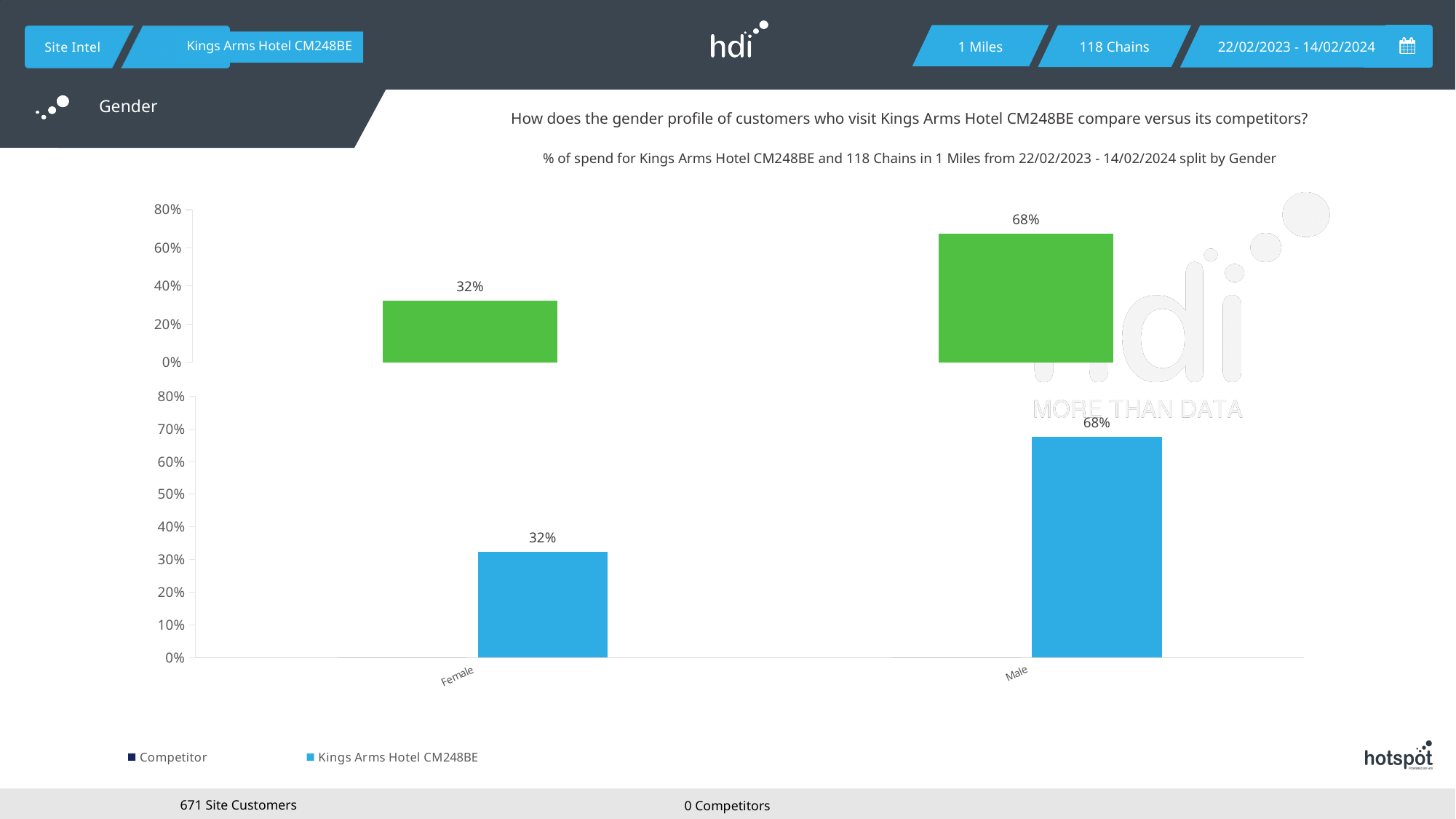
In the top chart, what is the value for Female? 32% In the bottom chart, what is the value for Female? 32% In the top chart, which category has the lowest value? Female In the bottom chart, is the value for Female greater or less than 40%? less What kind of chart is the bottom chart? Bar chart In the bottom chart, what is the value for Male? 68% In the bottom chart, which category has the highest value? Male How many categories are shown on the x axis of the bottom chart? 2 How many series does the legend at the bottom of the slide list? 2 In the top chart, is the value for Male greater or less than 60%? greater In the bottom chart, what is the difference between the Male and Female values? 36% In the top chart, what is the value for Male? 68%